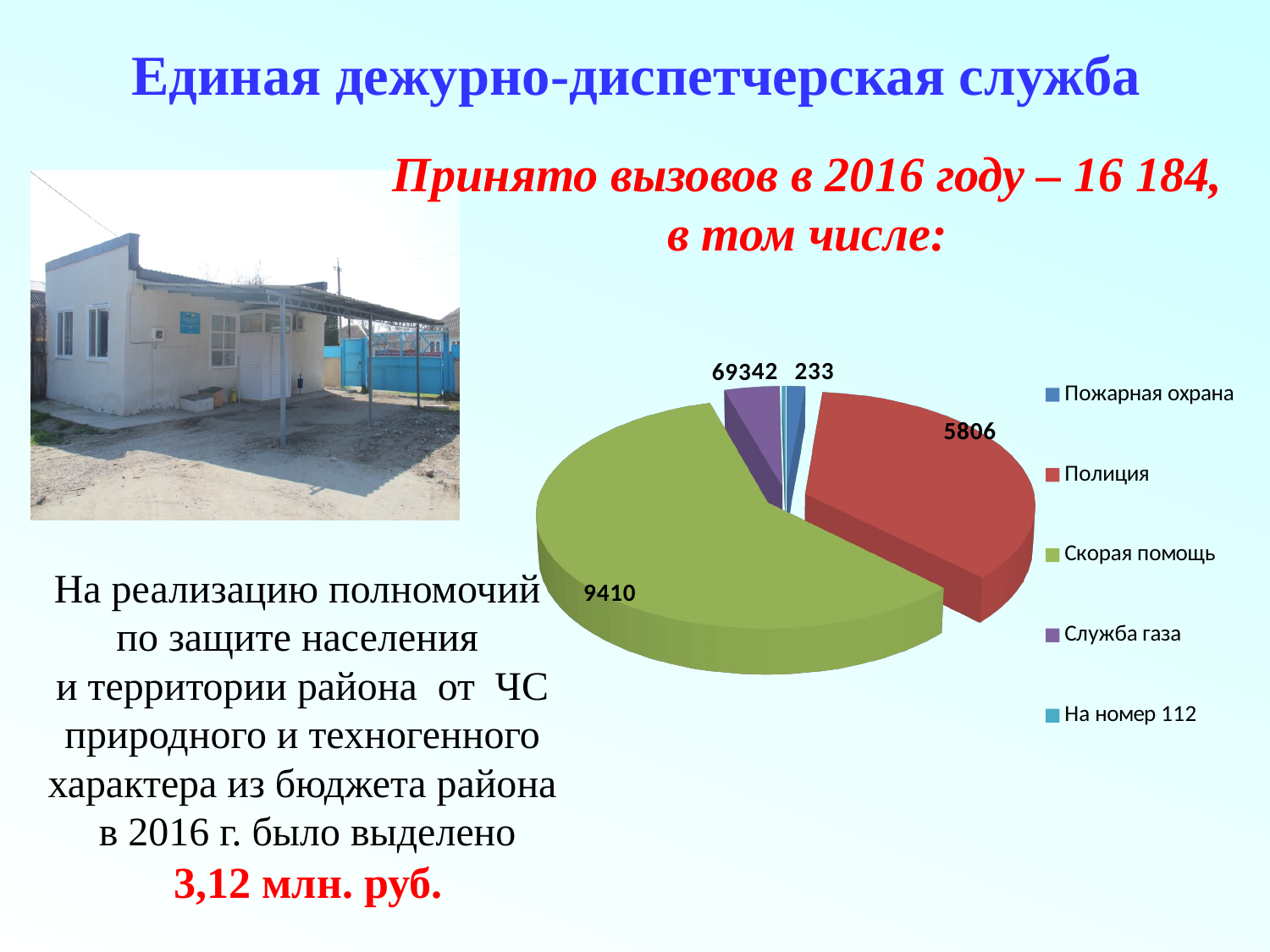
Which category has the largest slice in the pie chart? Скорая помощь How many calls were received for Полиция according to the pie chart? 5806 What value is shown for Скорая помощь in the pie chart? 9410 What kind of chart is shown on the slide? pie chart How many categories does the legend of the pie chart list? 5 What value is shown for Пожарная охрана in the pie chart? 233 What is the difference between the values for Скорая помощь and Полиция in the pie chart? 3604 What colour is the Скорая помощь slice in the pie chart? green Which category has the smallest slice in the pie chart? На номер 112 Which is larger in the pie chart: Полиция or Скорая помощь? Скорая помощь What total number of calls received in 2016 is stated above the pie chart? 16 184 Which is larger in the pie chart: Пожарная охрана or Полиция? Полиция